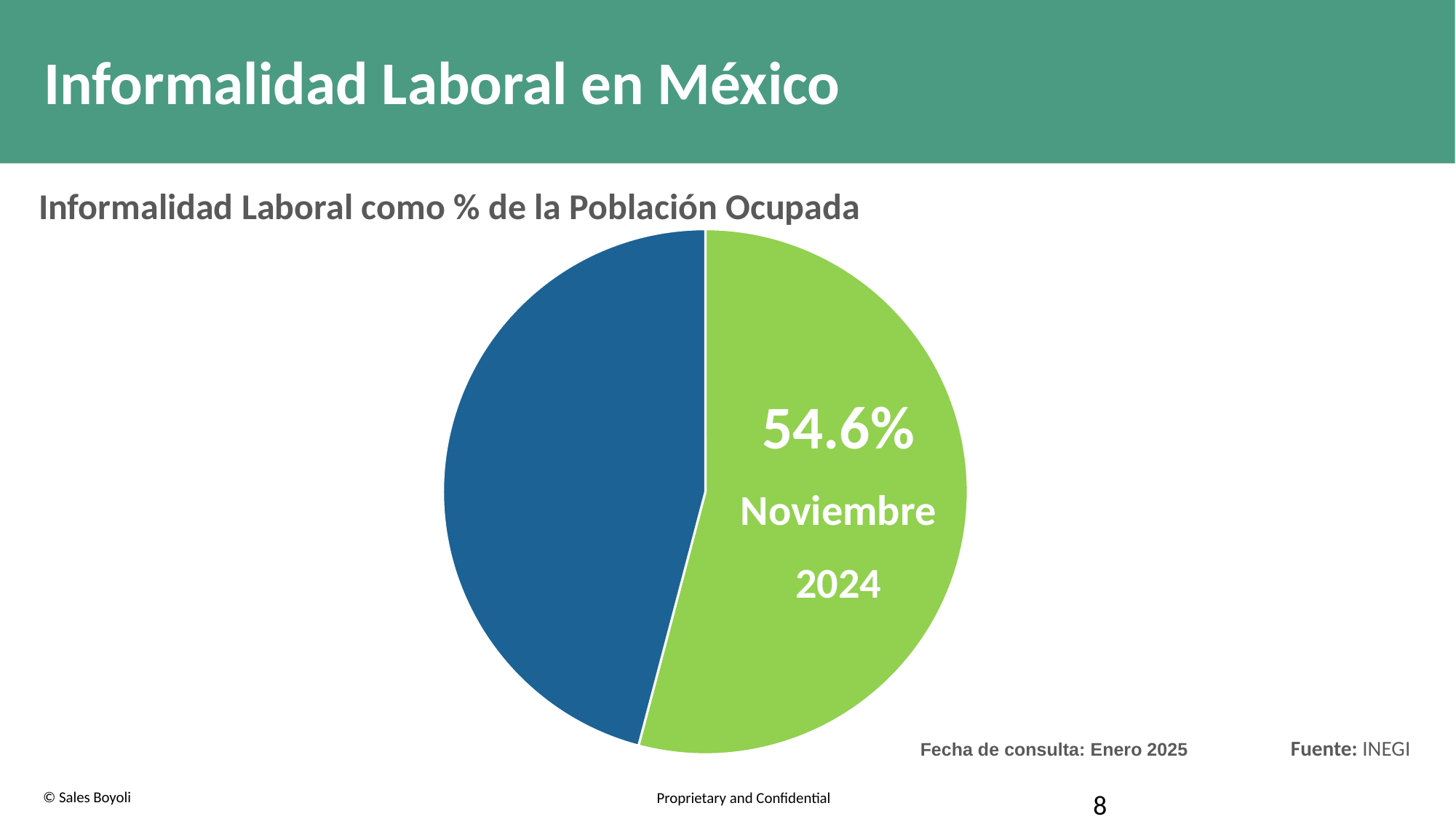
What colour is the slice that carries the 54.6% label? Green What kind of chart is shown on the slide? Pie chart What is the title of the chart? Informalidad Laboral como % de la Población Ocupada What share of the pie does the Noviembre 2024 slice represent? 54.6% Is the value for the Noviembre 2024 slice greater or less than 50%? greater Which slice is larger, the green slice or the blue slice? The green slice How many slices does the pie chart have? 2 Which month and year is labelled on the pie chart? Noviembre 2024 What value is printed on the green slice of the pie chart? 54.6%